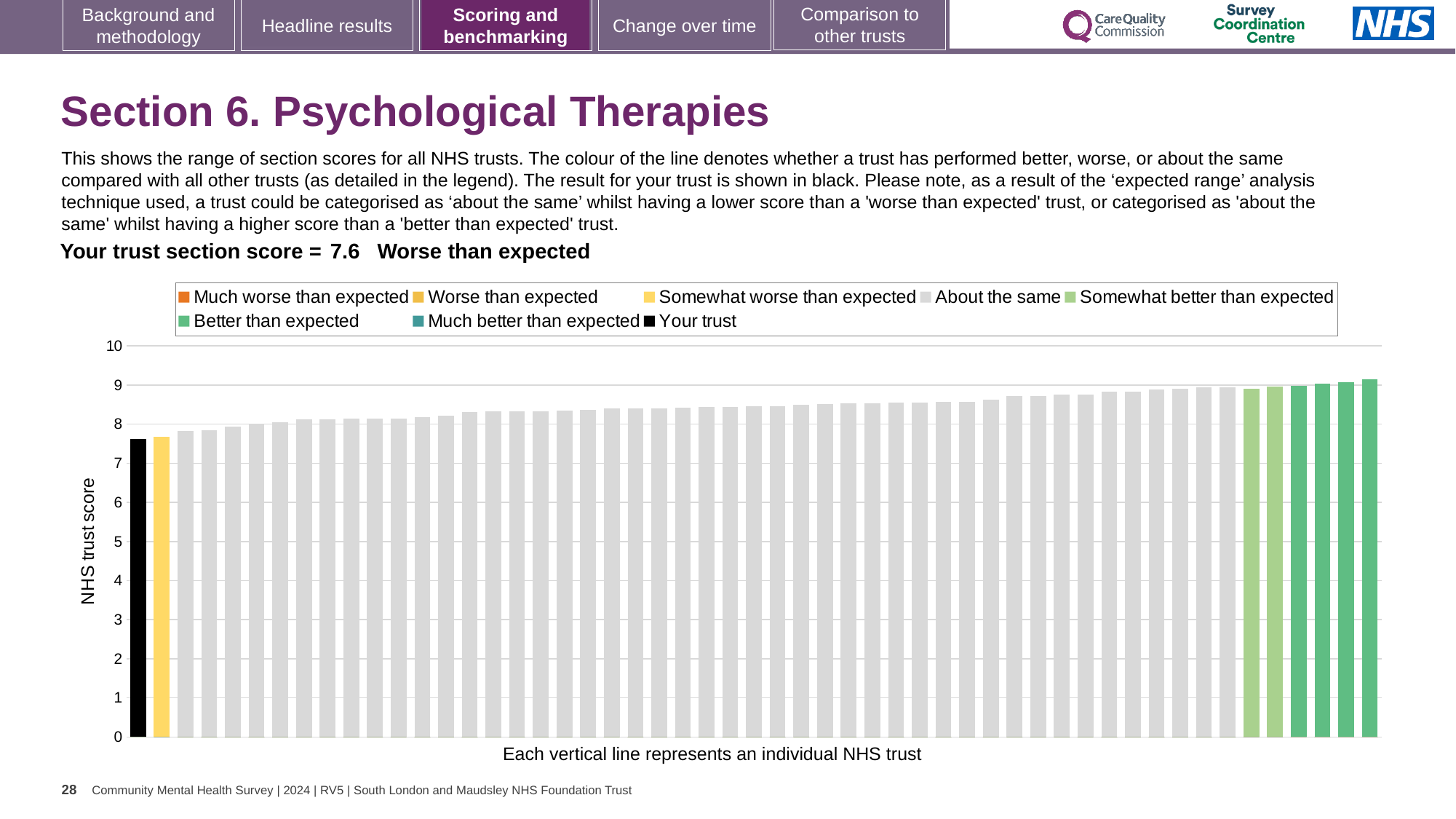
Is the value for your trust (the black bar) greater or less than 8? less Do the bar values rise or fall from left to right across the chart? Rise How many bars are coloured yellow (Worse than expected) on the chart? 1 Is the value of the tallest bar on the chart greater or less than 9? greater Is your trust's bar the lowest bar on the chart? Yes What does the caption below the chart say each vertical line represents? An individual NHS trust How many entries does the chart legend list? 8 Is the value of the tallest bar on the chart greater or less than 10? less What is the label on the vertical axis of the chart? NHS trust score What type of chart is shown on the slide? Bar chart What is the section score for your trust shown on the slide? 7.6 Which is larger, the black bar for your trust or the rightmost bar on the chart? The rightmost bar